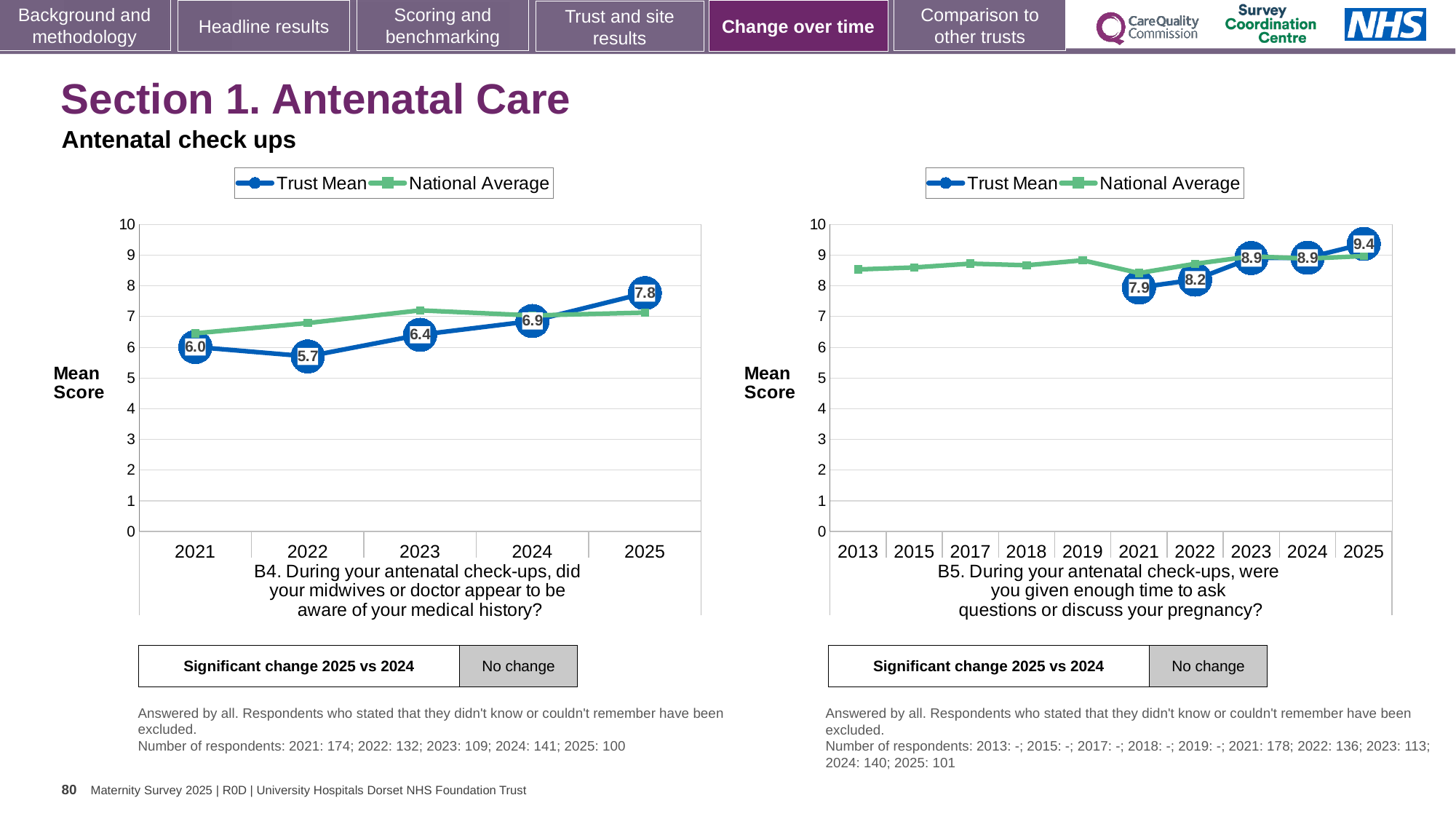
In the B5 chart (right), which year has the highest Trust Mean? 2025 In the B5 chart (right), does the Trust Mean generally rise or fall from 2021 to 2025? rise In the B4 chart (left), is the National Average for 2021 greater or less than 7? less In the B4 chart (left), which year has the lowest Trust Mean? 2022 In the B5 chart (right), what is the Trust Mean for 2025? 9.4 How many series does the legend of the B4 chart (left) list? 2 In the B4 chart (left), how many years are shown on the x axis? 5 In the B4 chart (left), what is the Trust Mean for 2022? 5.7 In the B5 chart (right), how many years are shown on the x axis? 10 In the B4 chart (left), what is the Trust Mean for 2025? 7.8 In the B4 chart (left), what is the difference between the Trust Mean in 2025 and in 2021? 1.8 In the B5 chart (right), which is larger, the Trust Mean for 2021 or for 2022? 2022